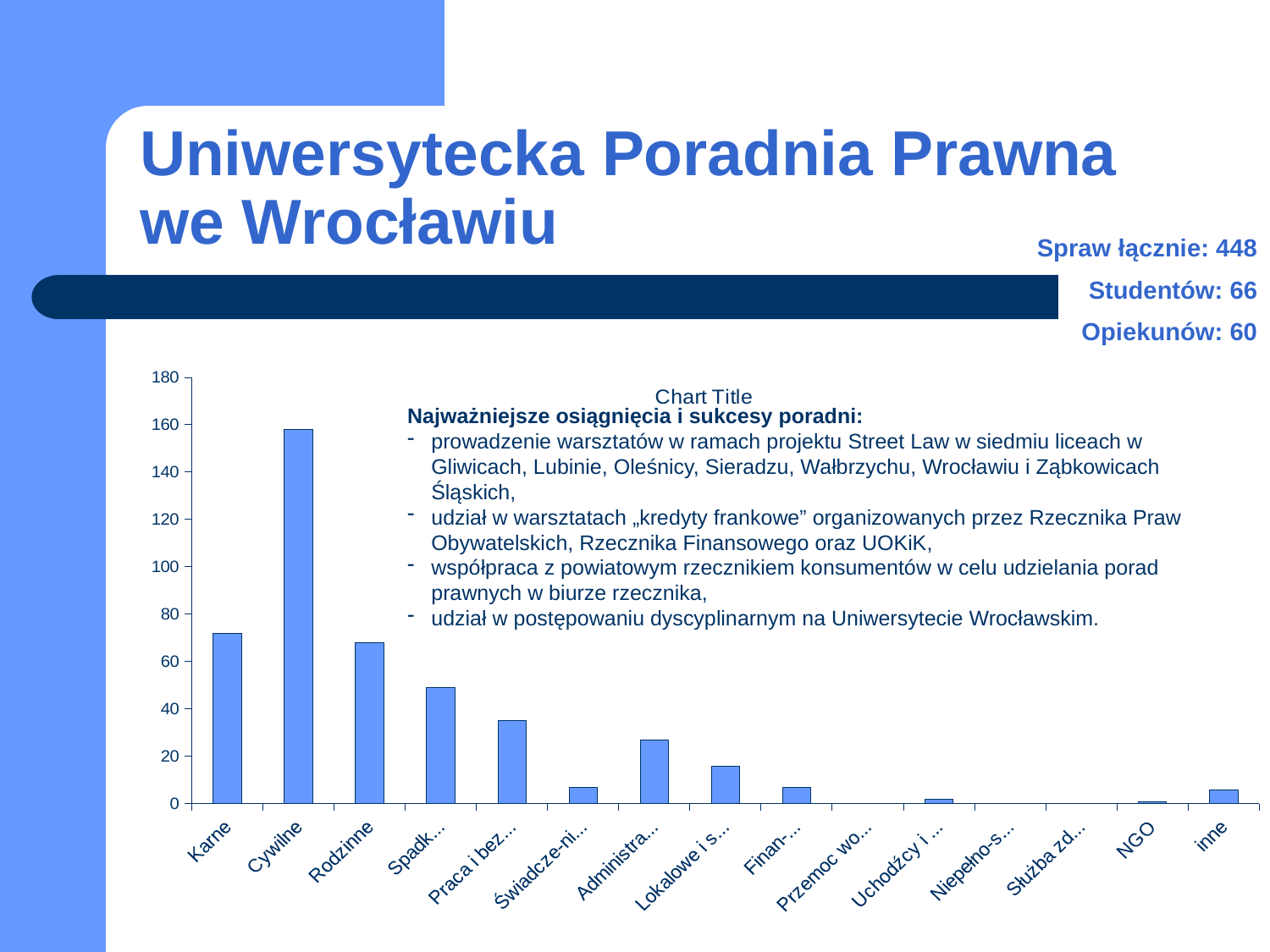
What is the title shown on the chart? Chart Title Which is larger, the value for Administra... or the value for Praca i bez...? Praca i bez... Which is larger, the value for Karne or the value for Spadk...? Karne Which category has the highest bar in the chart? Cywilne Is the value for Spadk... greater or less than 40? greater Is the value for Lokalowe i s... greater or less than 20? less What kind of chart is shown on the slide? bar chart Is the value for Rodzinne greater or less than 80? less How many categories are shown on the x axis of the chart? 15